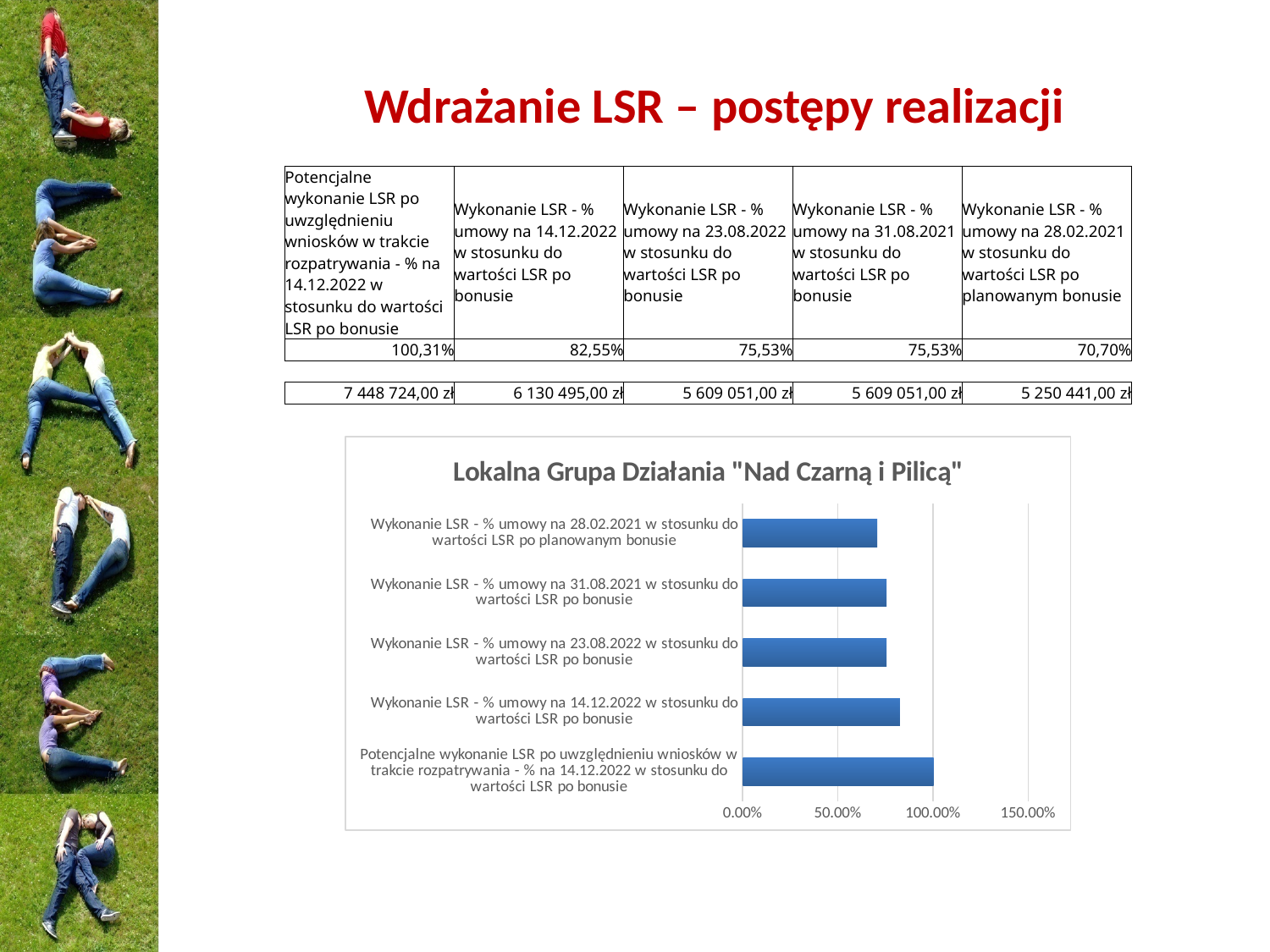
Is the value for "Wykonanie LSR - % umowy na 14.12.2022 w stosunku do wartości LSR po bonusie" greater or less than 100.00%? less Which category has the shortest bar in the chart? Wykonanie LSR - % umowy na 28.02.2021 w stosunku do wartości LSR po planowanym bonusie What type of chart is shown on the slide? Bar chart What is the highest value shown on the chart's horizontal axis? 150.00% How many categories (bars) does the chart show? 5 According to the table above the chart, what is the value for "Wykonanie LSR - % umowy na 14.12.2022 w stosunku do wartości LSR po bonusie"? 82,55% Which category has the longest bar in the chart? Potencjalne wykonanie LSR po uwzględnieniu wniosków w trakcie rozpatrywania - % na 14.12.2022 w stosunku do wartości LSR po bonusie What is the title of the chart on the slide? Lokalna Grupa Działania "Nad Czarną i Pilicą" According to the table above the chart, what is the value for "Potencjalne wykonanie LSR po uwzględnieniu wniosków w trakcie rozpatrywania - % na 14.12.2022 w stosunku do wartości LSR po bonusie"? 100,31% Is the value for "Wykonanie LSR - % umowy na 28.02.2021 w stosunku do wartości LSR po planowanym bonusie" greater or less than 50.00%? greater Which is larger: the value for "Wykonanie LSR - % umowy na 14.12.2022 w stosunku do wartości LSR po bonusie" or the value for "Wykonanie LSR - % umowy na 28.02.2021 w stosunku do wartości LSR po planowanym bonusie"? Wykonanie LSR - % umowy na 14.12.2022 w stosunku do wartości LSR po bonusie According to the table above the chart, what is the value for "Wykonanie LSR - % umowy na 28.02.2021 w stosunku do wartości LSR po planowanym bonusie"? 70,70%